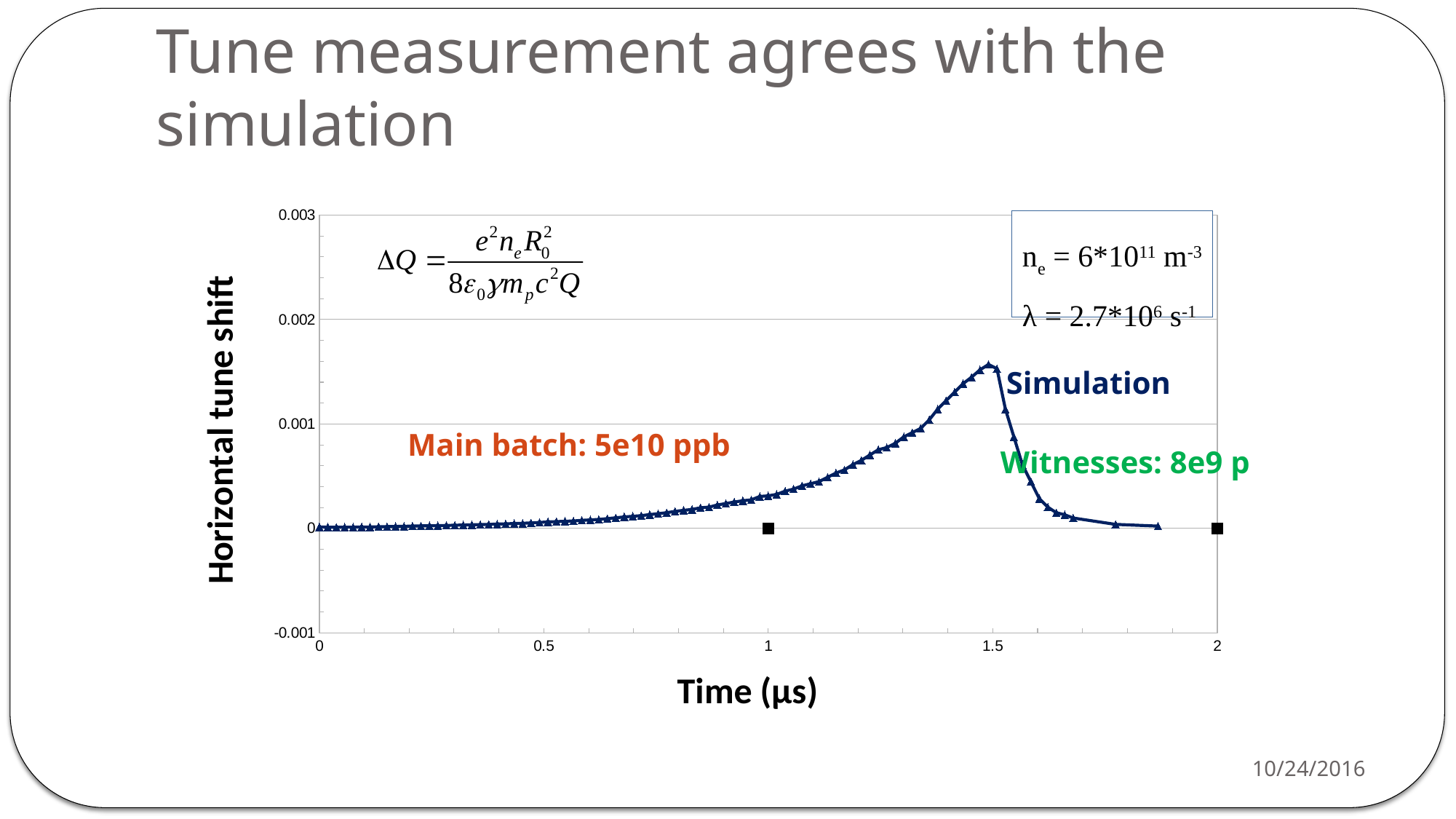
Does the Simulation curve rise or fall between time 0 and time 1.5 μs? rise Is the value of the Simulation curve at time 1.75 μs greater or less than 0.001? less Is the value of the Simulation curve at time 1 μs greater or less than 0.001? less Is the value of the Simulation curve at time 1.5 μs larger or smaller than its value at time 1 μs? larger Is the value of the Simulation curve at time 1.5 μs greater or less than 0.001? greater What is the label of the y axis of the chart? Horizontal tune shift What kind of chart is shown on the slide? line chart What is the label of the x axis of the chart? Time (μs) Does the Simulation curve rise or fall between time 1.5 μs and time 1.75 μs? fall